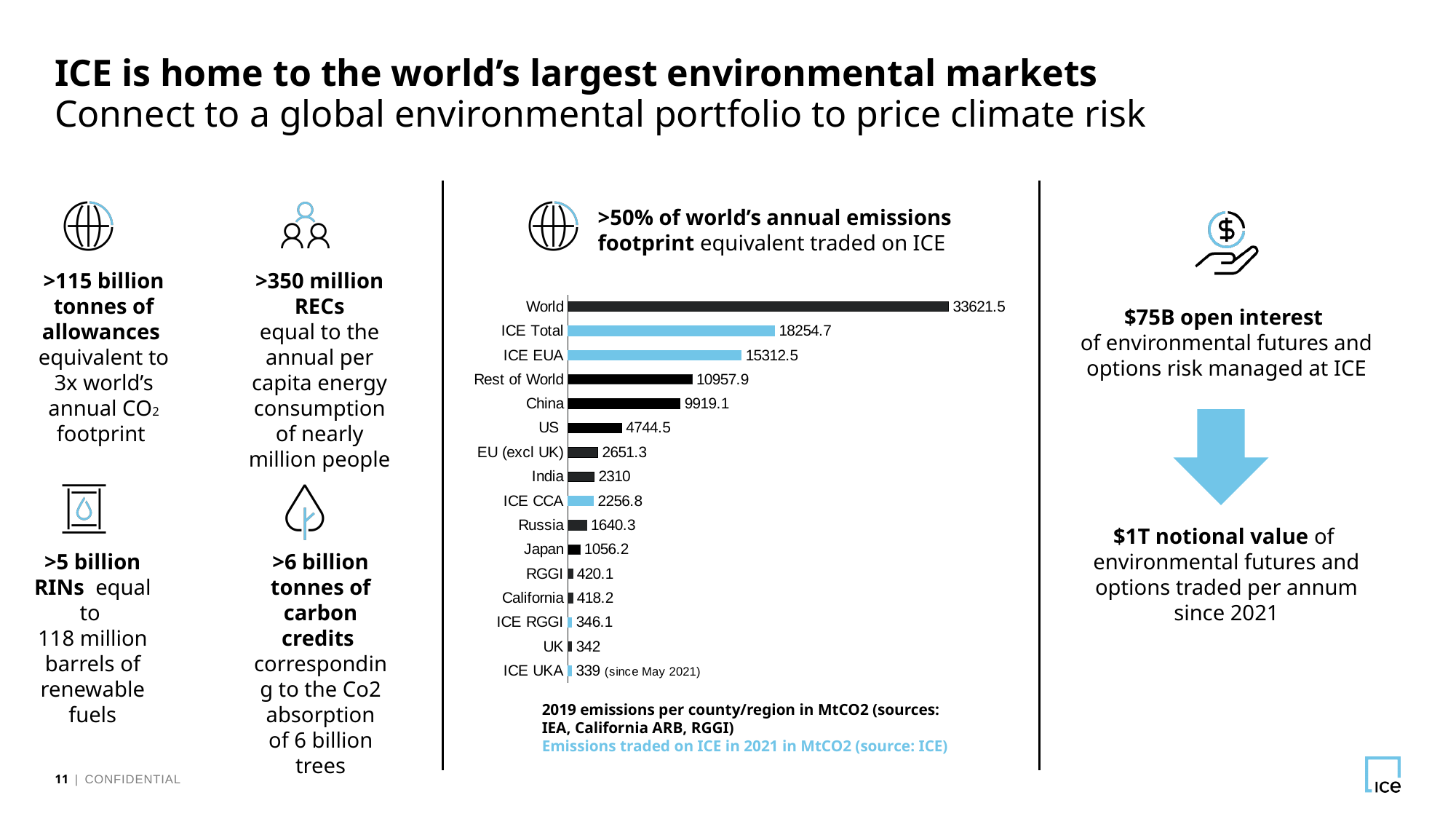
What is the value shown for ICE CCA in the bar chart? 2256.8 What is the difference between the China value and the US value? 5174.6 Which is larger, the value for Russia or the value for Japan? Russia Which category has the lowest value in the bar chart? ICE UKA Which category has the highest value in the bar chart? World What is the value shown for World in the bar chart? 33621.5 How many categories are plotted in the bar chart? 16 What is the difference between the World value and the ICE Total value? 15366.8 What is the value shown for China in the bar chart? 9919.1 What kind of chart is shown on the slide? Bar chart What is the value shown for ICE UKA in the bar chart? 339 What is the value shown for ICE Total in the bar chart? 18254.7